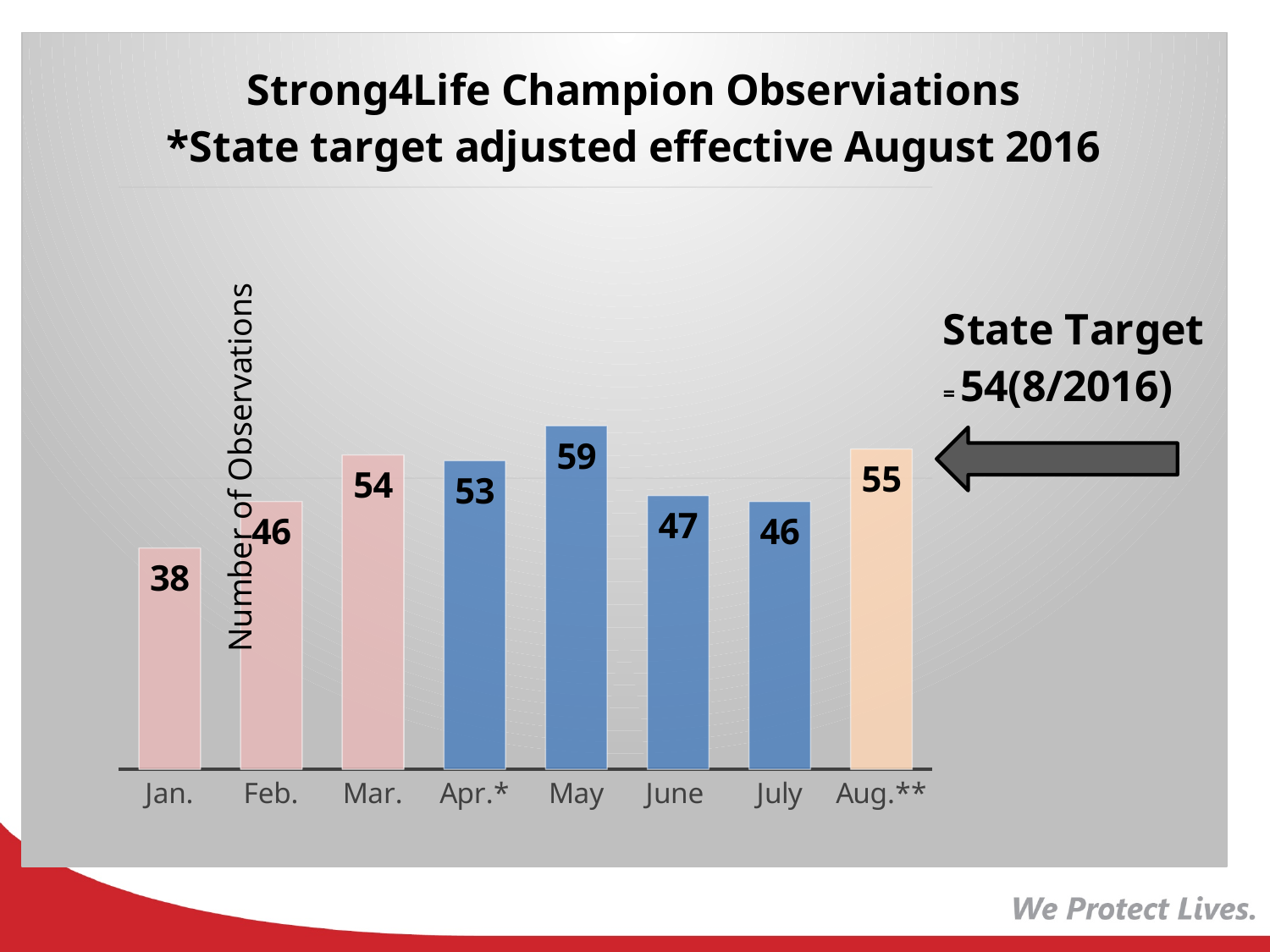
Which is larger, the value for Apr.* or the value for June? Apr.* What is the number of observations for Jan.? 38 What is the number of observations for May? 59 Which month has the highest number of observations? May What is the state target shown on the slide? 54 How many months are shown on the x axis? 8 Do the values rise or fall from June to July? Fall What is the difference between the observations in May and in July? 13 What kind of chart is shown on the slide? Bar chart What is the difference between the observations in Mar. and in Feb.? 8 What is the number of observations for Aug.**? 55 Which month has the lowest number of observations? Jan.